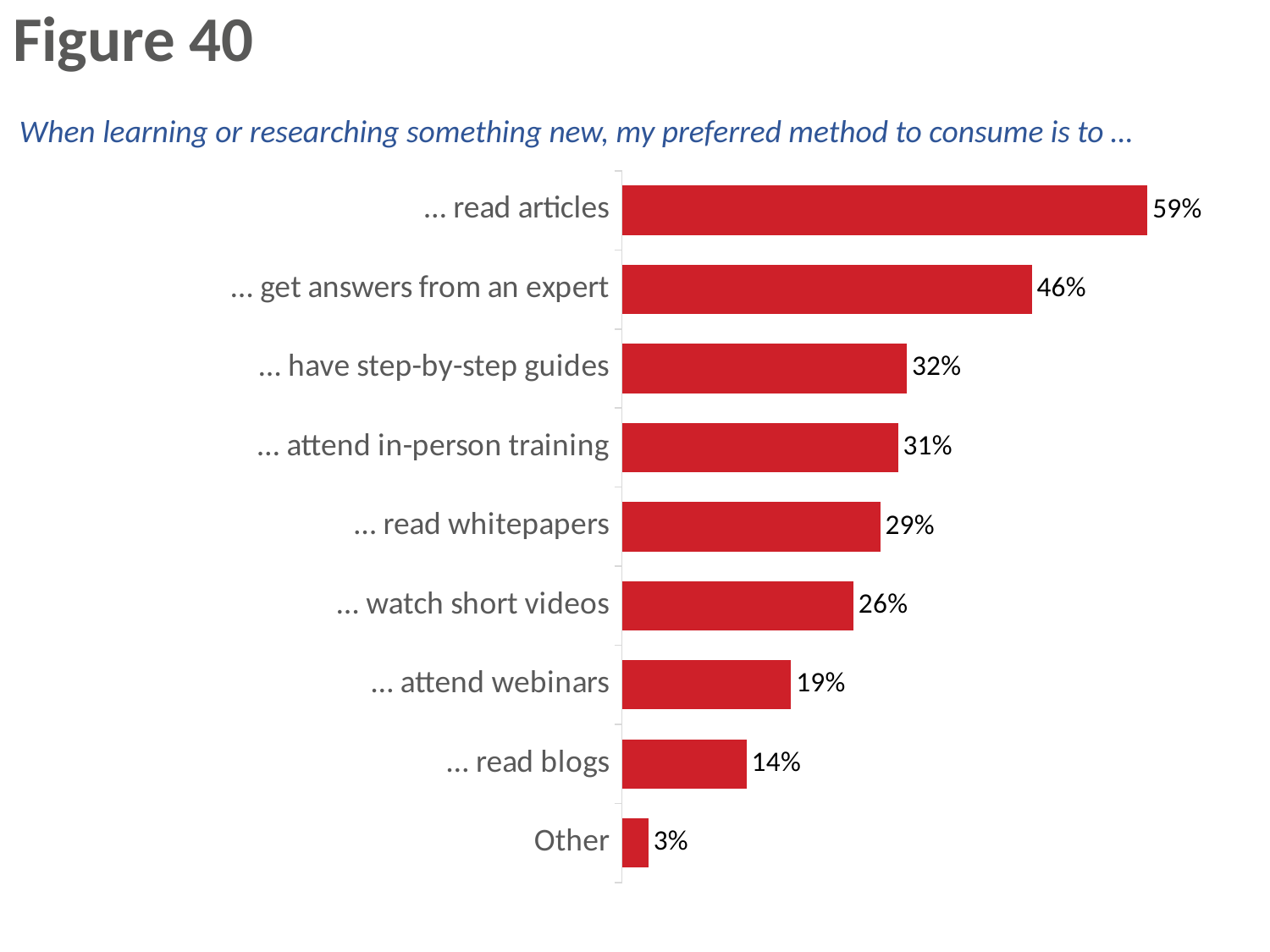
Which is larger: '... have step-by-step guides' or '... read whitepapers'? ... have step-by-step guides What percentage is shown for '... attend webinars'? 19% What is the value shown for '... watch short videos'? 26% What is the difference between '... read articles' and '... get answers from an expert'? 13% What is the difference between '... read whitepapers' and '... read blogs'? 15% What colour are the bars in the chart? Red Which preferred method has the highest percentage? ... read articles What percentage of respondents prefer to read articles when learning something new? 59% What type of chart is shown on the slide? Bar chart Which category has the lowest percentage? Other What is the figure number shown at the top of the slide? Figure 40 How many categories are shown in the chart? 9